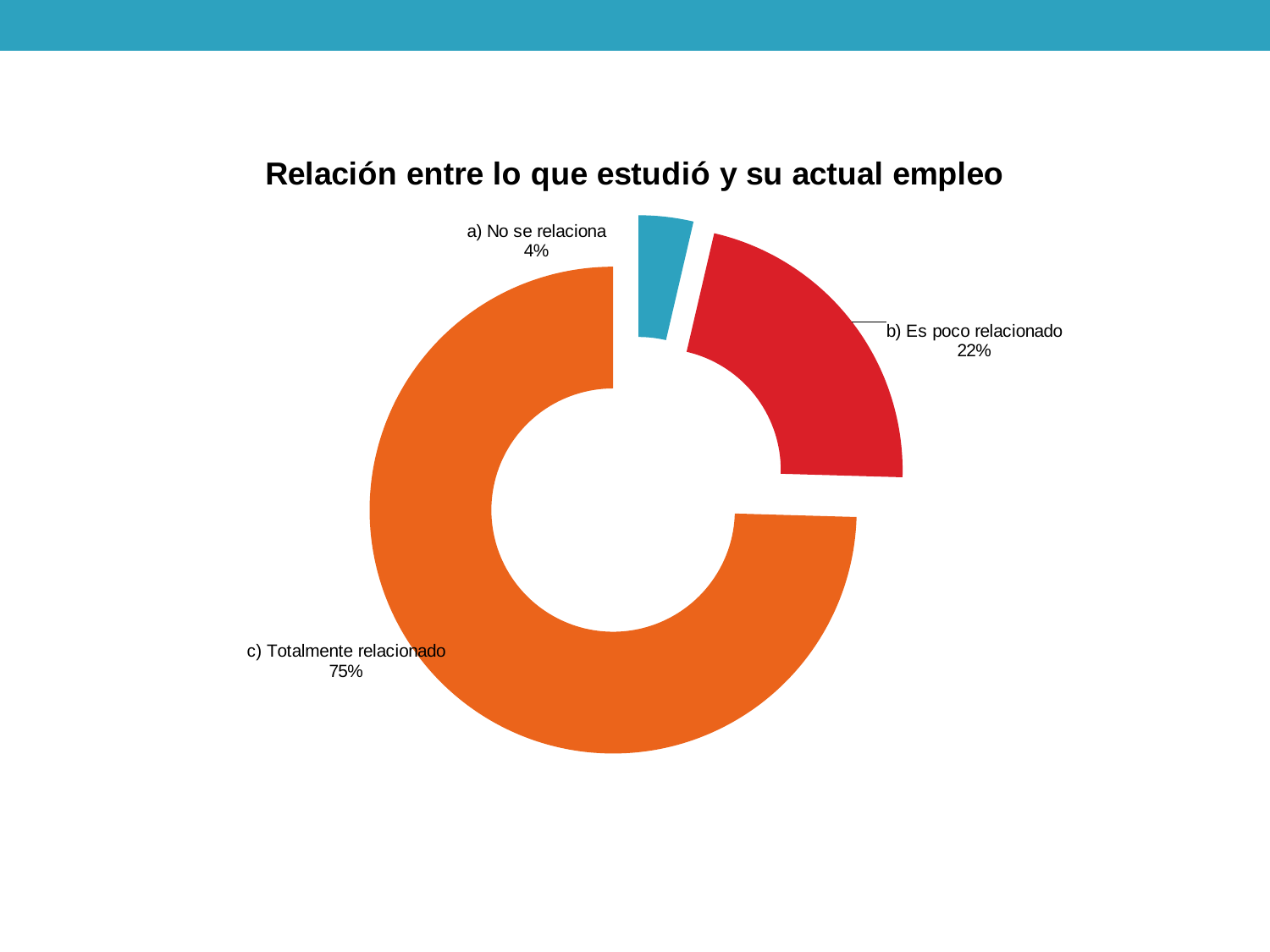
Which category has the smallest share of the chart? a) No se relaciona How many categories are shown in the chart? 3 What share of the pie does "a) No se relaciona" represent? 4% What share of the pie does "c) Totalmente relacionado" represent? 75% Which is larger, the share for "b) Es poco relacionado" or the share for "a) No se relaciona"? b) Es poco relacionado What kind of chart is shown on the slide? Pie chart (doughnut) What is the difference in percentage points between "b) Es poco relacionado" and "a) No se relaciona"? 18 What is the title of the chart? Relación entre lo que estudió y su actual empleo What colour is the slice for "c) Totalmente relacionado"? Orange What is the difference in percentage points between "c) Totalmente relacionado" and "b) Es poco relacionado"? 53 What share of the pie does "b) Es poco relacionado" represent? 22% Which category has the largest share of the chart? c) Totalmente relacionado